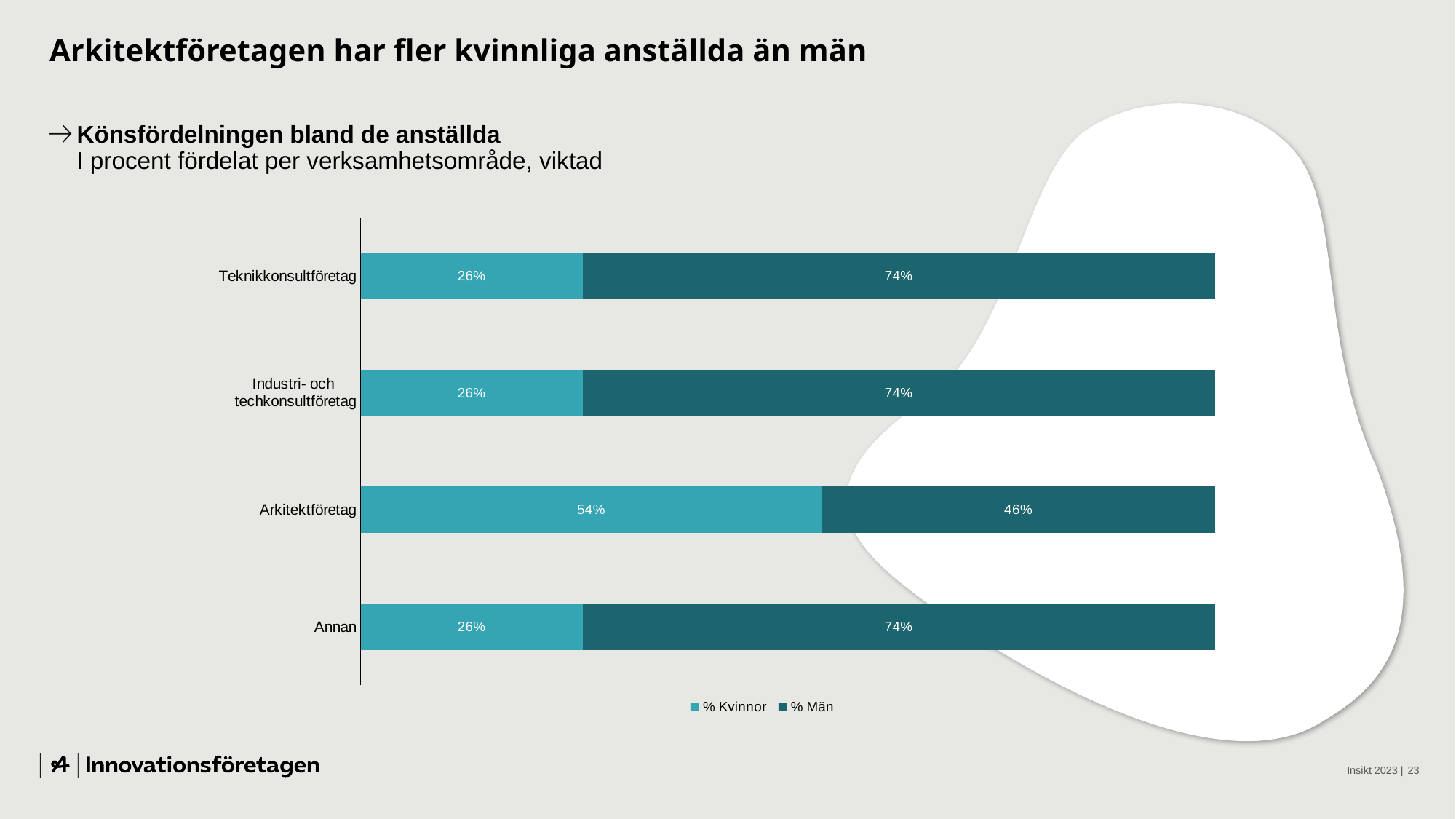
For Arkitektföretag, which is larger: % Kvinnor or % Män? % Kvinnor What is the % Män value for Teknikkonsultföretag? 74% What kind of chart is shown on the slide? Stacked bar chart Which category has the highest % Kvinnor value? Arkitektföretag What is the difference between the % Kvinnor values for Arkitektföretag and Teknikkonsultföretag? 28% Which category has the lowest % Män value? Arkitektföretag What is the % Kvinnor value for Industri- och techkonsultföretag? 26% What is the % Kvinnor value for Arkitektföretag? 54% How many categories are shown on the chart? 4 How many series does the legend list? 2 What is the % Män value for Annan? 74% What is the difference between the % Män and % Kvinnor values for Arkitektföretag? 8%